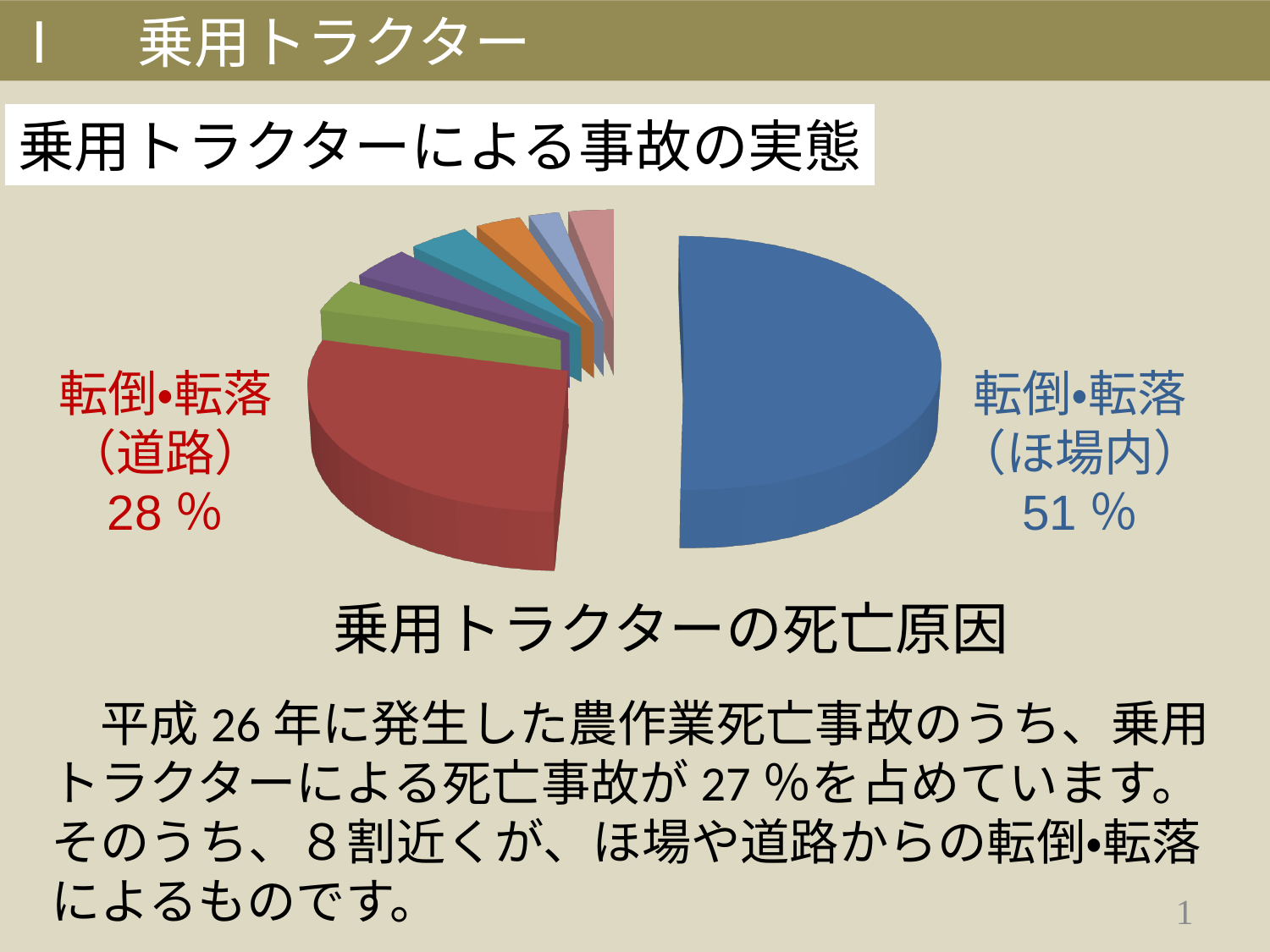
What is the title of the chart? 乗用トラクターの死亡原因 What colour is the slice for 転倒・転落（ほ場内）? Blue What share of the pie does 転倒・転落（ほ場内） account for? 51 % What share of the pie does 転倒・転落（道路） account for? 28 % By how many percentage points does 転倒・転落（ほ場内） exceed 転倒・転落（道路）? 23 percentage points Is the share for 転倒・転落（道路） greater or less than 30 %? less What is the combined share of the two labelled slices, 転倒・転落（ほ場内） and 転倒・転落（道路）? 79 % Which labelled category has the largest slice of the pie? 転倒・転落（ほ場内） Which is larger, the slice for 転倒・転落（ほ場内） or the slice for 転倒・転落（道路）? 転倒・転落（ほ場内） How many slices does the pie chart have? 8 What kind of chart is shown on the slide? Pie chart Is the share for 転倒・転落（ほ場内） greater or less than 50 %? greater